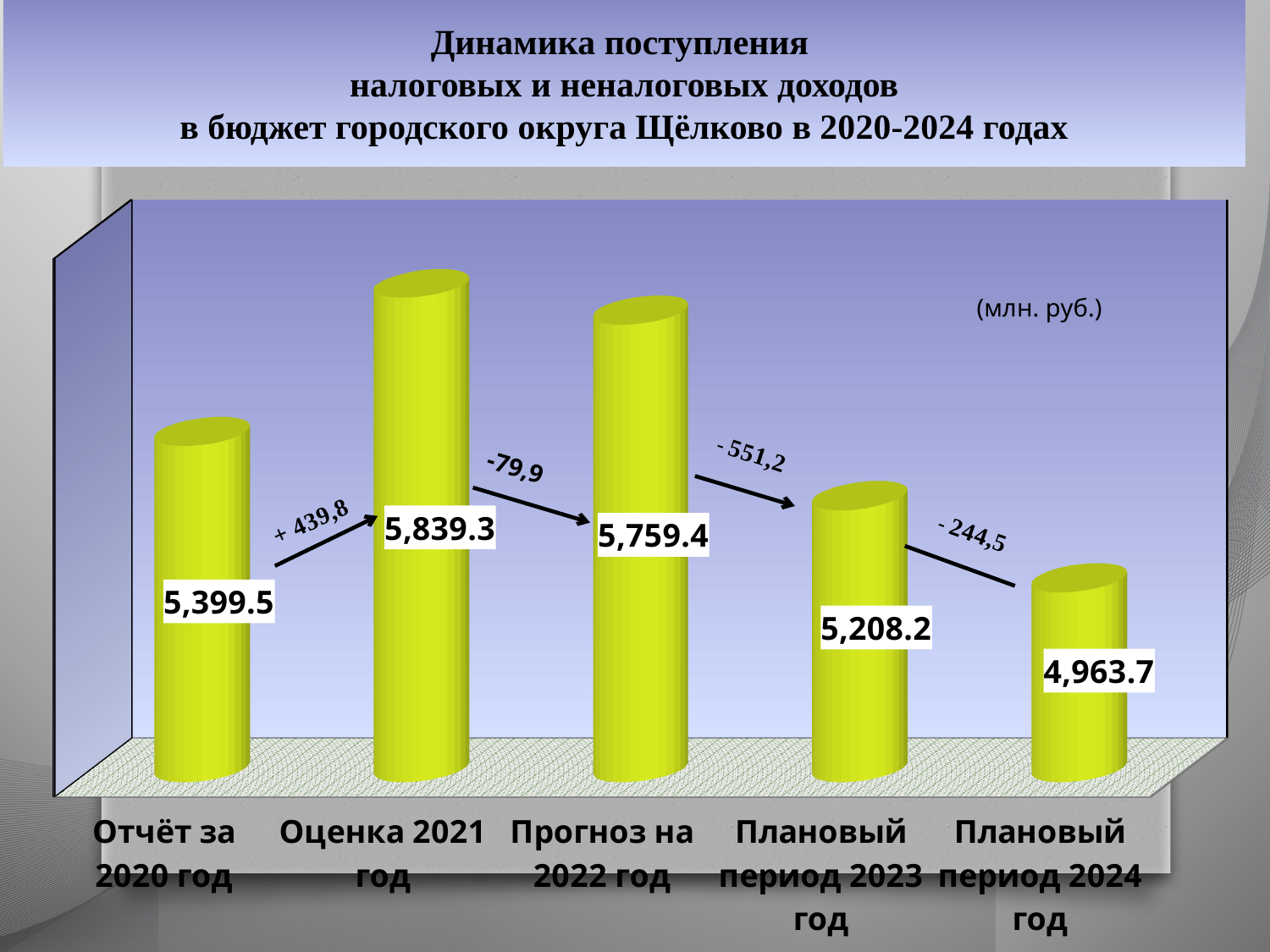
What is the difference between the values for Оценка 2021 год and Отчёт за 2020 год? 439.8 From Оценка 2021 год to Плановый период 2024 год, do the values rise or fall? fall How many categories are shown on the chart? 5 Which is larger, the value for Прогноз на 2022 год or the value for Плановый период 2023 год? Прогноз на 2022 год What kind of chart is shown on the slide? bar chart What is the value for Оценка 2021 год? 5,839.3 Which category has the highest value? Оценка 2021 год Which category has the lowest value? Плановый период 2024 год What is the value for Прогноз на 2022 год? 5,759.4 What is the difference between the values for Плановый период 2023 год and Плановый период 2024 год? 244.5 What is the value for Плановый период 2024 год? 4,963.7 What is the value for Отчёт за 2020 год? 5,399.5